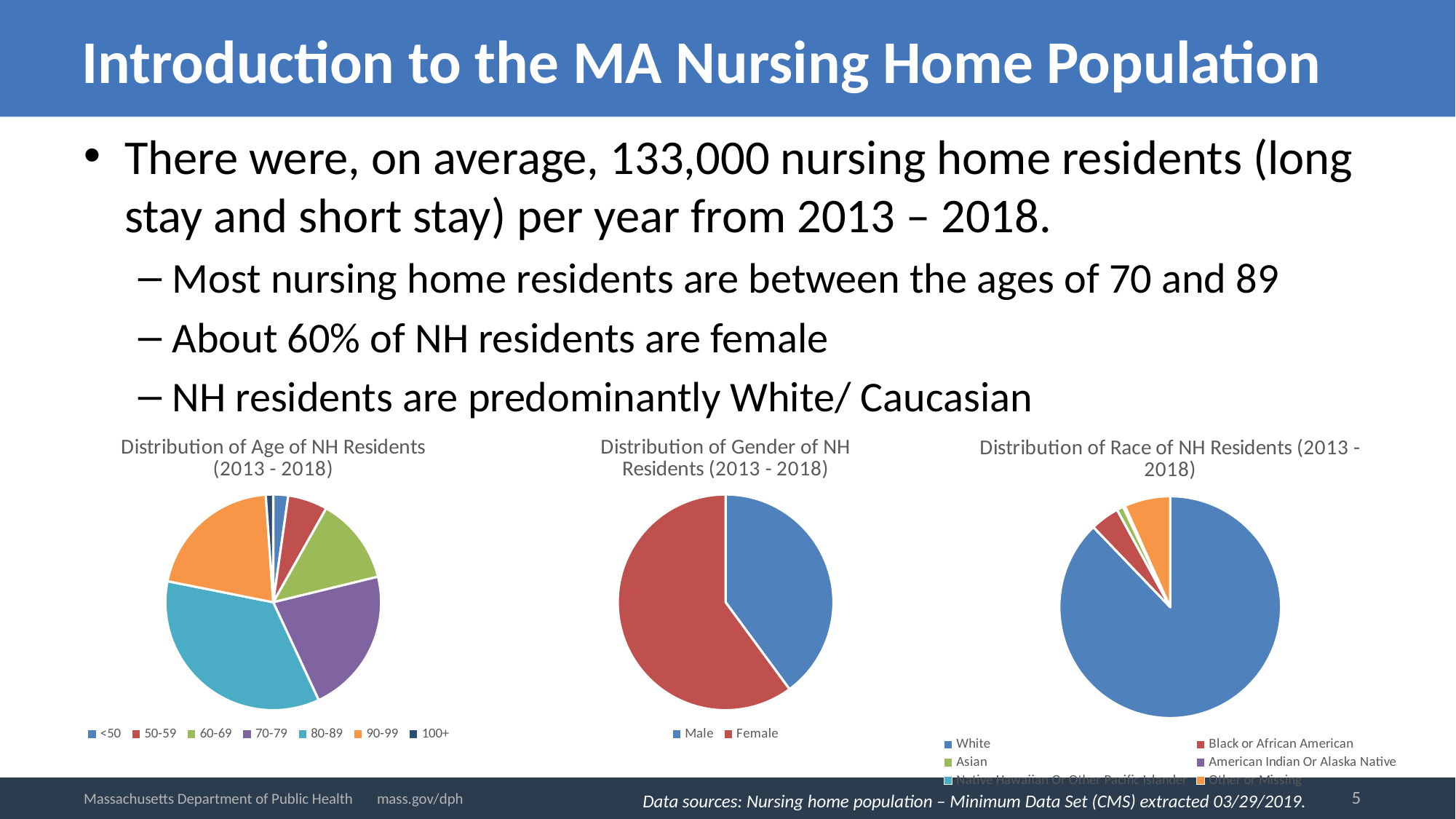
In the 'Distribution of Gender of NH Residents (2013 - 2018)' chart, which gender has the larger slice? Female In the 'Distribution of Race of NH Residents (2013 - 2018)' chart, which slice is larger, Asian or Black or African American? Black or African American In the 'Distribution of Age of NH Residents (2013 - 2018)' chart, which slice is larger, 60-69 or 90-99? 90-99 In the 'Distribution of Gender of NH Residents (2013 - 2018)' chart, what colour is the Male slice? blue In the 'Distribution of Race of NH Residents (2013 - 2018)' chart, how many race categories does the legend list? 6 What kind of chart is the 'Distribution of Age of NH Residents (2013 - 2018)' chart? pie chart In the 'Distribution of Gender of NH Residents (2013 - 2018)' chart, how many categories are shown? 2 In the 'Distribution of Race of NH Residents (2013 - 2018)' chart, which race category has the largest slice? White In the 'Distribution of Age of NH Residents (2013 - 2018)' chart, which age group has the largest slice? 80-89 What kind of chart is the 'Distribution of Race of NH Residents (2013 - 2018)' chart? pie chart In the 'Distribution of Age of NH Residents (2013 - 2018)' chart, which slice is larger, 70-79 or 80-89? 80-89 In the 'Distribution of Age of NH Residents (2013 - 2018)' chart, how many age categories does the legend list? 7